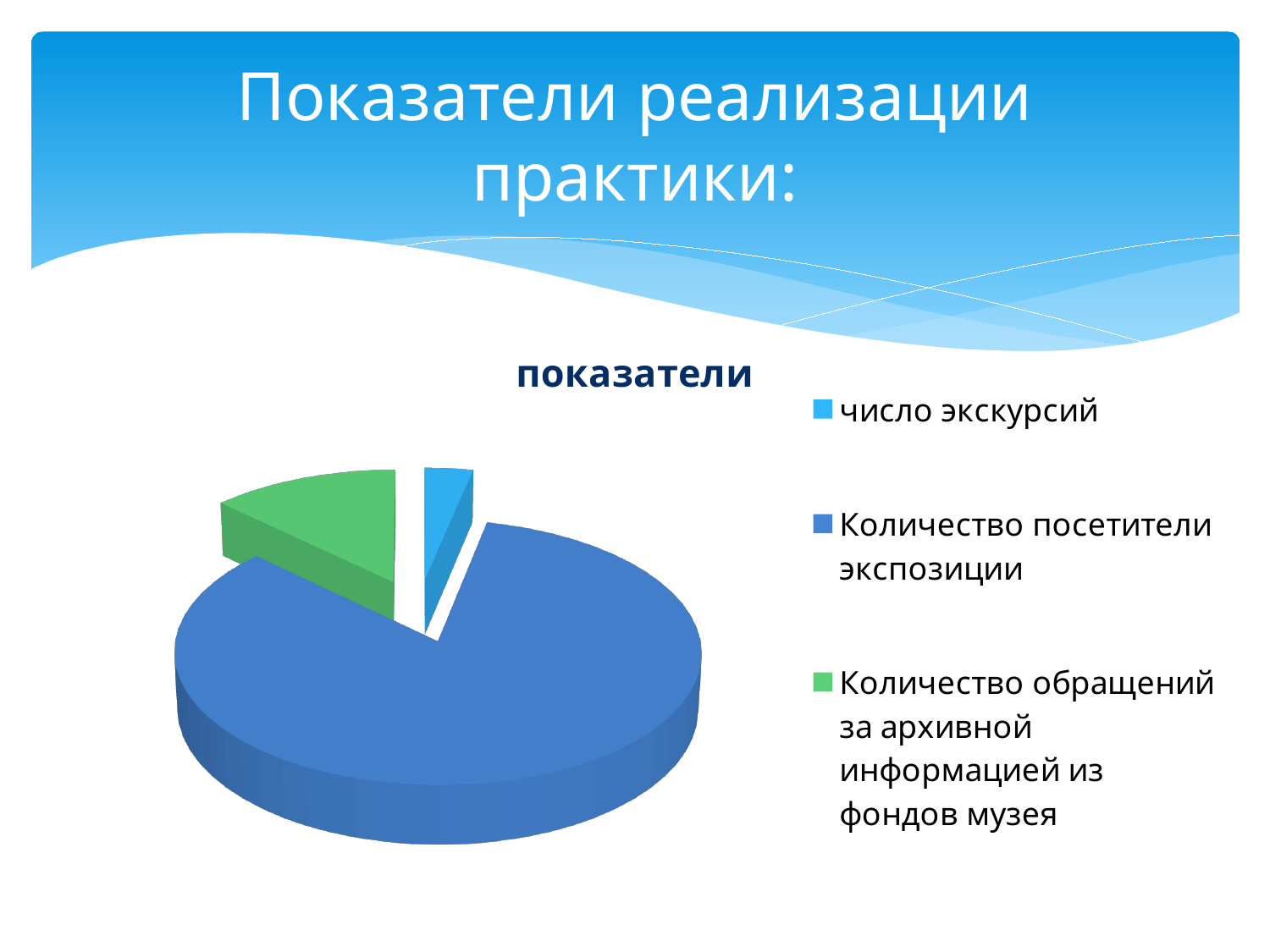
Which is larger: the slice for число экскурсий or the slice for Количество обращений за архивной информацией из фондов музея? Количество обращений за архивной информацией из фондов музея How many entries does the chart legend list? 3 What kind of chart is shown on the slide? Pie chart Which category has the smallest slice of the pie? число экскурсий Which is larger: the slice for Количество посетители экспозиции or the slice for Количество обращений за архивной информацией из фондов музея? Количество посетители экспозиции Which category has the largest slice of the pie? Количество посетители экспозиции How many slices does the pie chart have? 3 What is the title of the chart? показатели What colour is the slice for Количество обращений за архивной информацией из фондов музея? Green